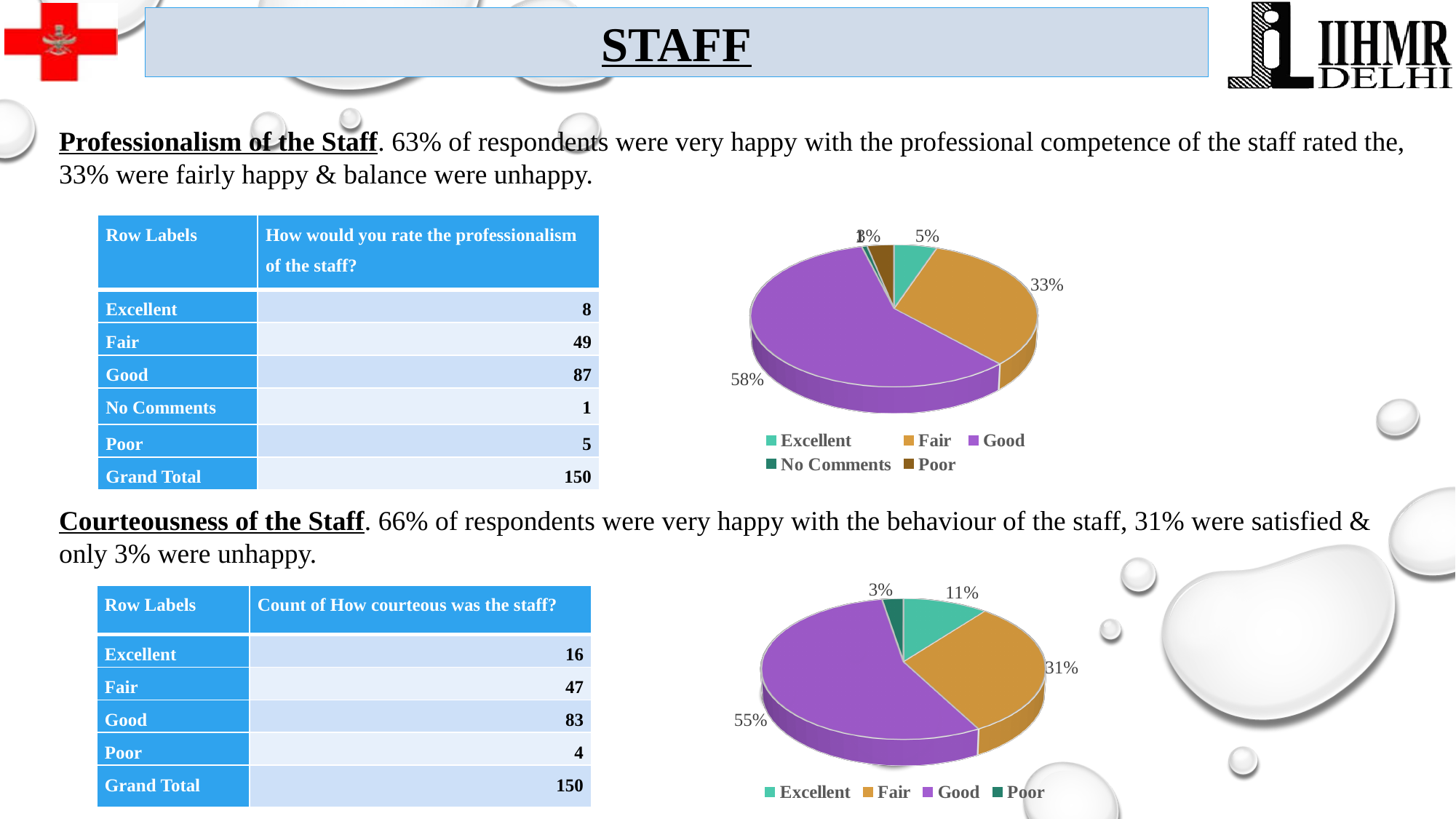
In the bottom pie chart (courteousness of the staff), what share is labelled for the Excellent slice? 11% What type of chart is used for the professionalism of the staff data? Pie chart In the top pie chart (professionalism of the staff), what share is labelled for the Fair slice? 33% In the top pie chart (professionalism of the staff), which category has the largest slice? Good In the bottom pie chart (courteousness of the staff), which category has the smallest slice? Poor How many categories does the legend of the top pie chart (professionalism of the staff) list? 5 How many categories does the legend of the bottom pie chart (courteousness of the staff) list? 4 In the bottom pie chart (courteousness of the staff), what is the difference in percentage points between the Good and Fair slices? 24 In the top pie chart (professionalism of the staff), what share is labelled for the Excellent slice? 5% In the top pie chart (professionalism of the staff), what share is labelled for the Good slice? 58% In the bottom pie chart (courteousness of the staff), what share is labelled for the Poor slice? 3% In the bottom pie chart (courteousness of the staff), what share is labelled for the Good slice? 55%